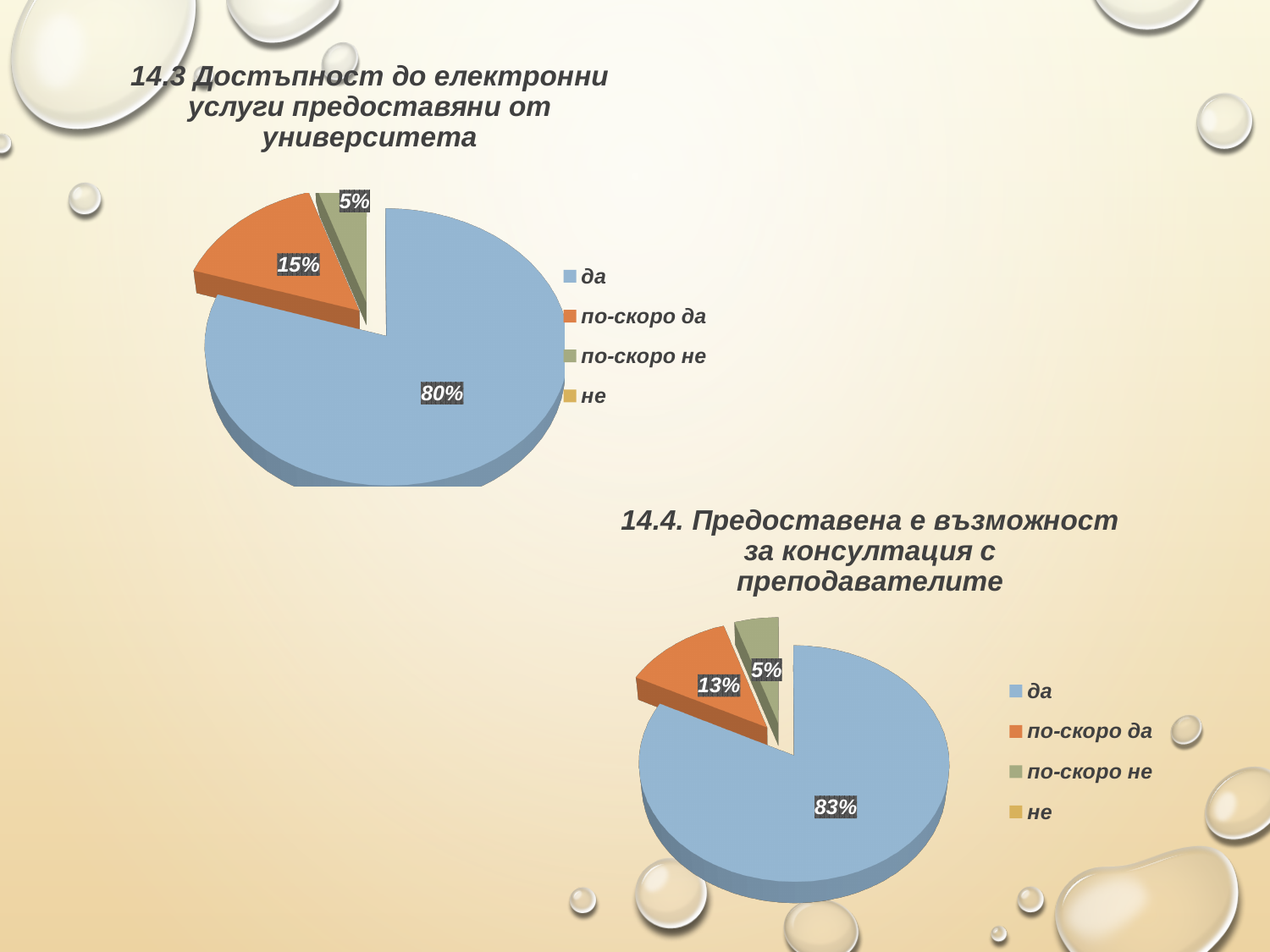
In the chart titled "14.4. Предоставена е възможност за консултация с преподавателите", which is larger, the share for "по-скоро да" or for "по-скоро не"? по-скоро да In the chart titled "14.3 Достъпност до електронни услуги предоставяни от университета", what percentage is shown for "да"? 80% In the chart titled "14.4. Предоставена е възможност за консултация с преподавателите", what percentage is shown for "да"? 83% What type of chart is the chart titled "14.4. Предоставена е възможност за консултация с преподавателите"? pie chart How many entries does the legend of the chart titled "14.3 Достъпност до електронни услуги предоставяни от университета" list? 4 In the chart titled "14.4. Предоставена е възможност за консултация с преподавателите", what percentage is shown for "по-скоро не"? 5% In the chart titled "14.3 Достъпност до електронни услуги предоставяни от университета", what percentage is shown for "по-скоро не"? 5% In the chart titled "14.3 Достъпност до електронни услуги предоставяни от университета", which category has the largest share? да In the chart titled "14.3 Достъпност до електронни услуги предоставяни от университета", what percentage is shown for "по-скоро да"? 15% In the chart titled "14.3 Достъпност до електронни услуги предоставяни от университета", what is the difference between the shares for "да" and "по-скоро да"? 65% In the chart titled "14.4. Предоставена е възможност за консултация с преподавателите", which category has the largest share? да In the chart titled "14.4. Предоставена е възможност за консултация с преподавателите", what percentage is shown for "по-скоро да"? 13%